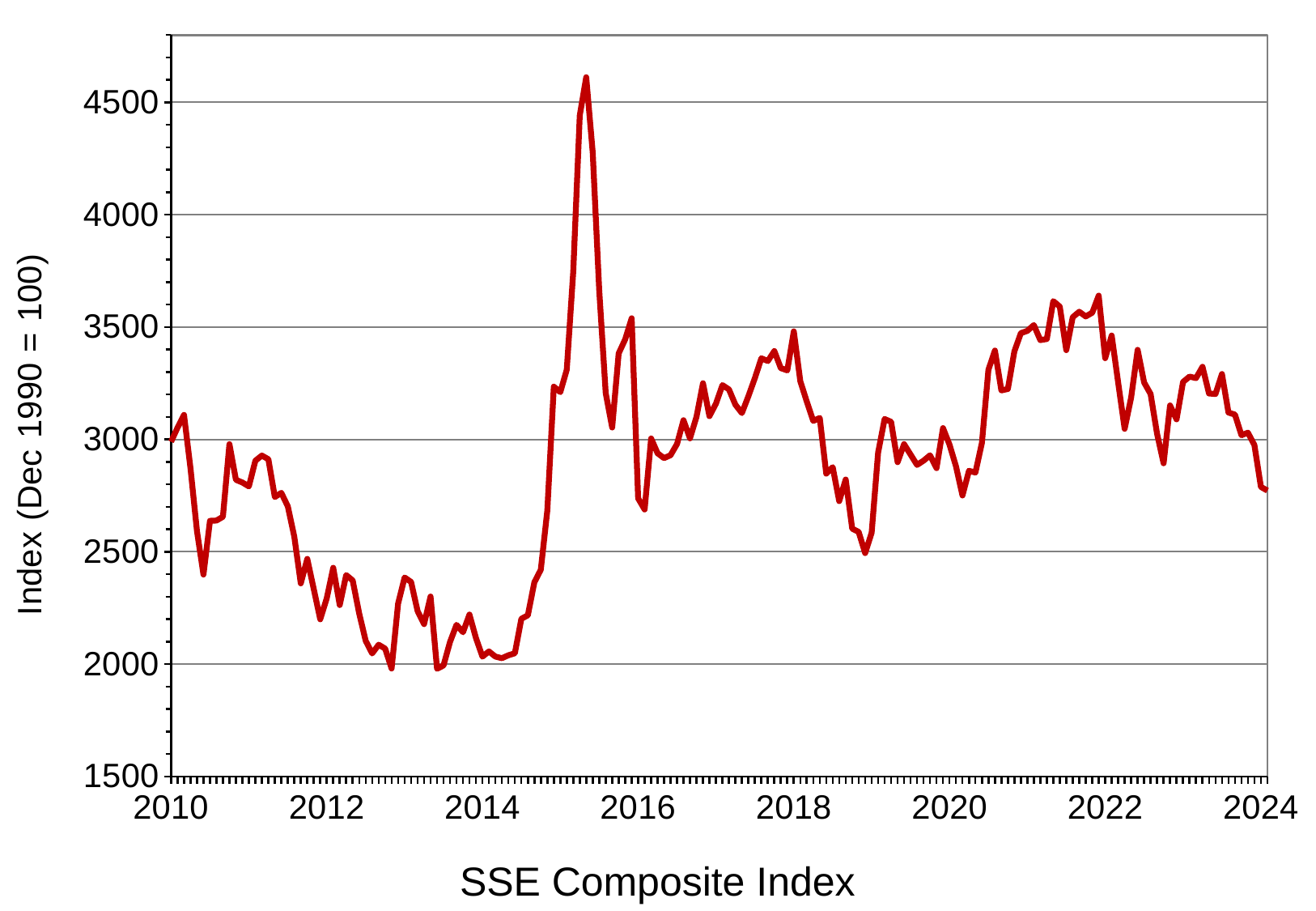
Does the index rise or fall between the start of 2022 and the end of 2024? fall What is the title of the chart? SSE Composite Index Which is larger, the index value at the start of 2018 or at the start of 2014? 2018 In which year does the SSE Composite Index reach its highest value on the chart? 2015 Is the peak value of the index in 2015 greater or less than 4500? greater What is the label on the vertical axis of the chart? Index (Dec 1990 = 100) How many lines (series) are plotted on the chart? 1 Is the value of the index at the end of the chart in 2024 greater or less than 3000? less Does the index generally rise or fall between 2010 and 2014? fall What kind of chart is shown on the slide? line chart Is the value of the index at the start of 2018 greater or less than 3000? greater